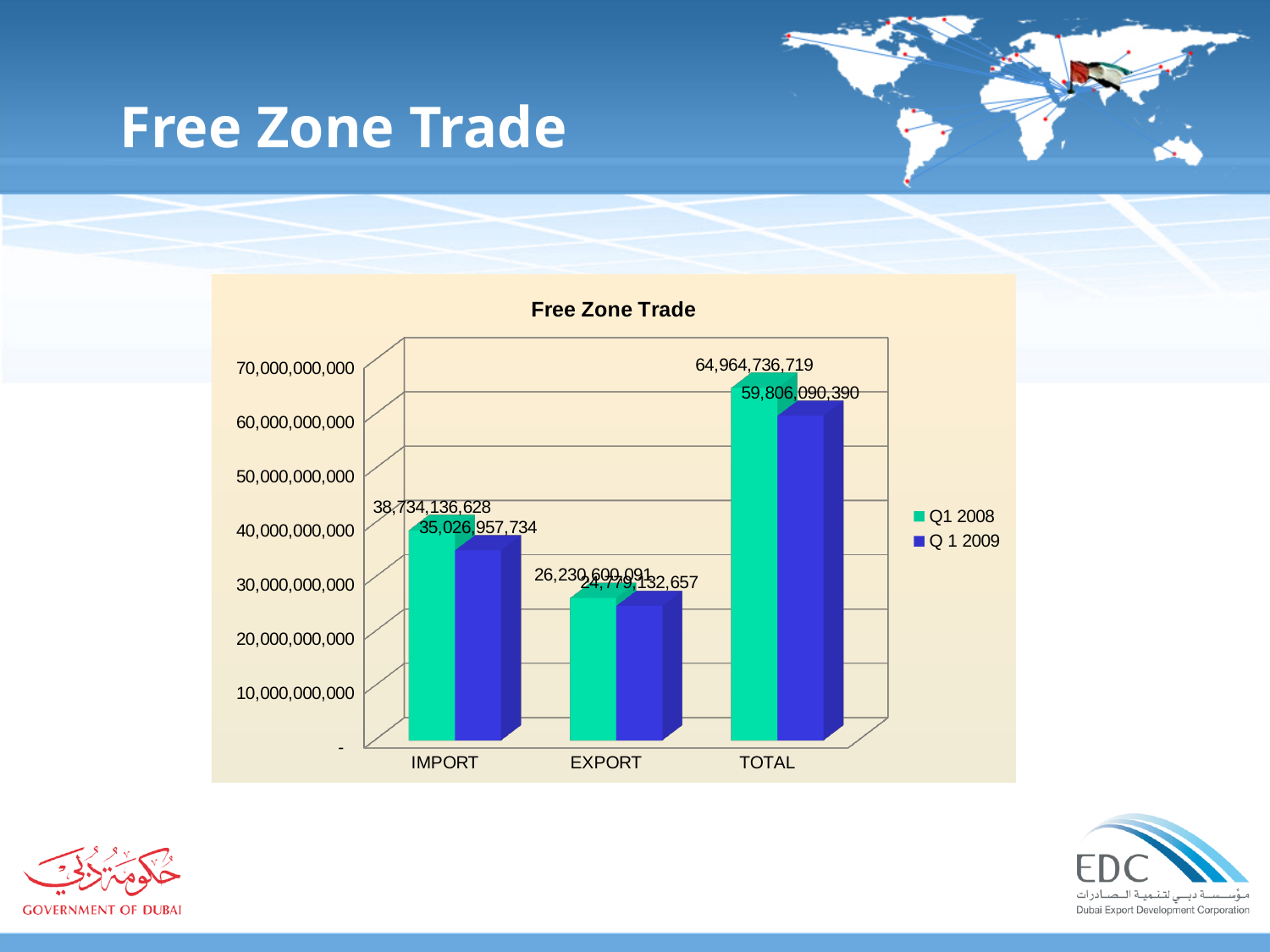
What is the Q 1 2009 value for TOTAL? 59,806,090,390 What is the Q 1 2009 value for IMPORT? 35,026,957,734 How many series does the legend list? 2 What is the Q1 2008 value for IMPORT? 38,734,136,628 What is the Q1 2008 value for TOTAL? 64,964,736,719 What kind of chart is shown? Bar chart For IMPORT, which series is larger, Q1 2008 or Q 1 2009? Q1 2008 Which category has the highest Q1 2008 value? TOTAL Is the Q 1 2009 value for EXPORT greater or less than 30,000,000,000? less What is the difference between the Q1 2008 and Q 1 2009 values for TOTAL? 5,158,646,329 Which category has the lowest Q 1 2009 value? EXPORT How many categories are shown on the x axis? 3